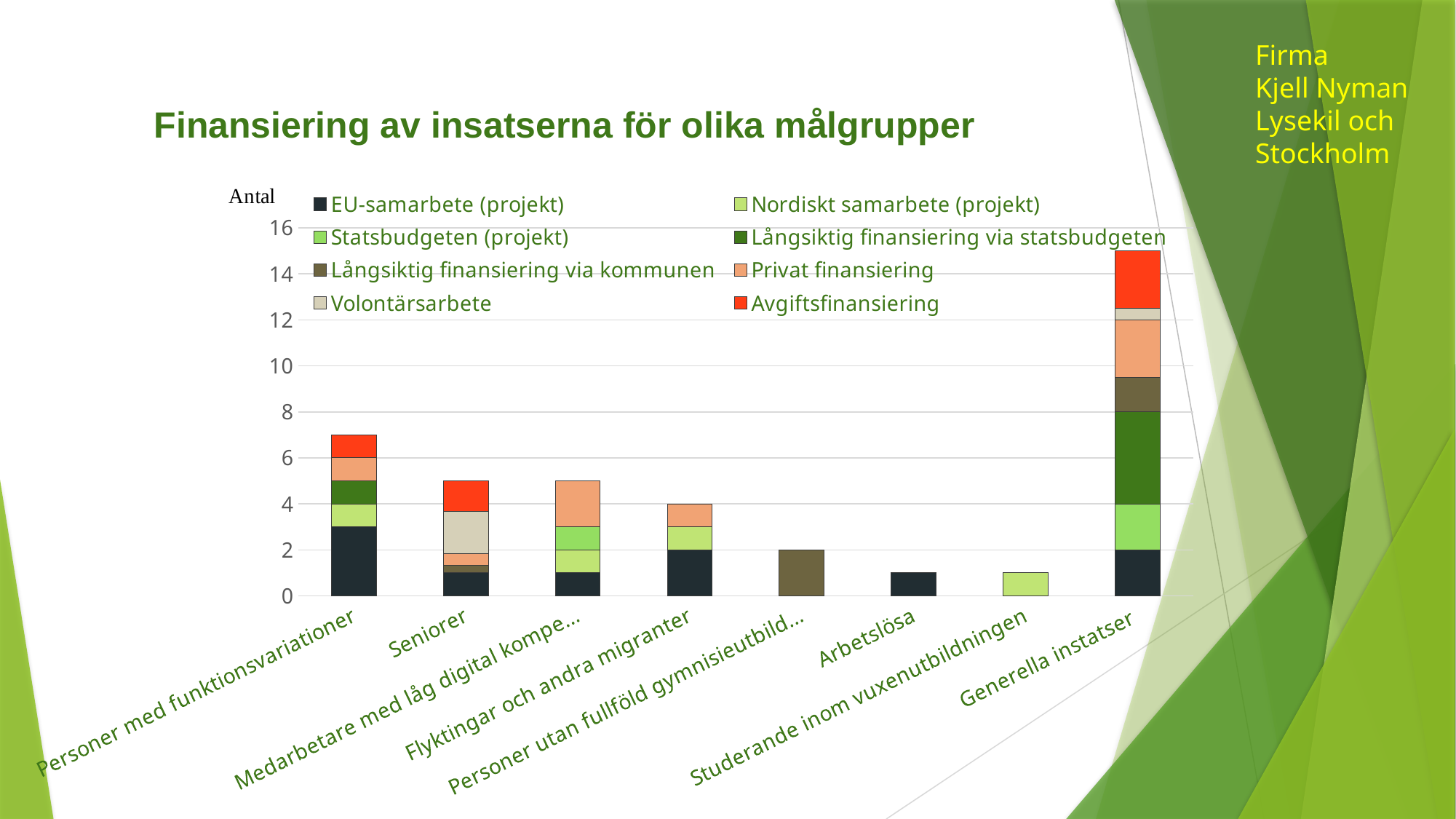
What is the total height of the stacked bar for Flyktingar och andra migranter? 4 What label is shown on the vertical axis of the chart? Antal How many series does the legend list? 8 Which category has the tallest stacked bar? Generella instatser Is the total for Arbetslösa greater or less than 2? less Is the total for Generella instatser greater or less than 14? greater Is the total for Personer med funktionsvariationer greater or less than 6? greater How many categories are shown on the x axis of the chart? 8 Which has a taller stacked bar, Seniorer or Generella instatser? Generella instatser What kind of chart is shown on the slide? Stacked bar chart What is the total height of the stacked bar for Personer utan fullföld gymnisieutbild...? 2 What is the title of the chart? Finansiering av insatserna för olika målgrupper